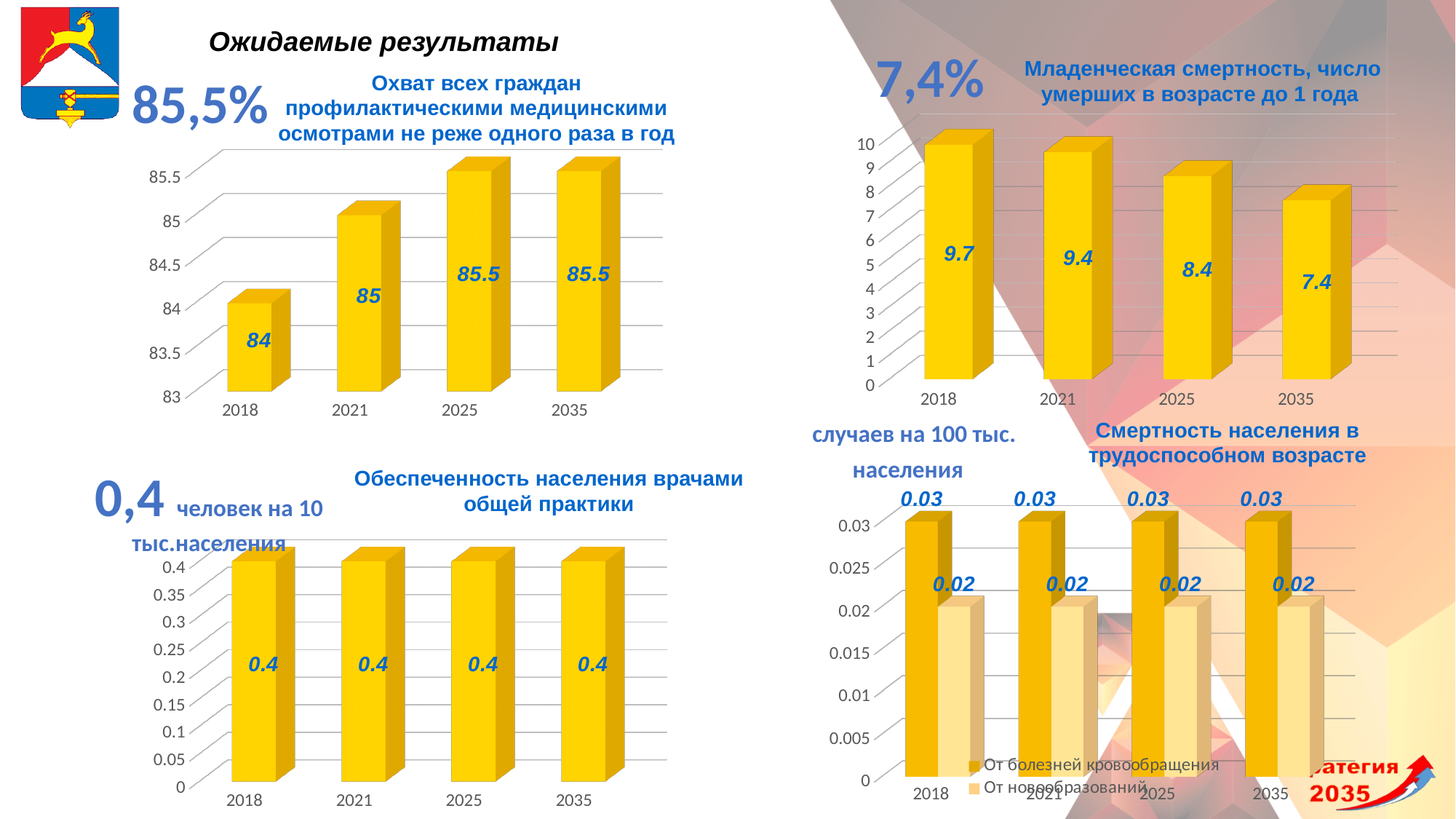
In the chart 'Младенческая смертность, число умерших в возрасте до 1 года', do the values rise or fall from 2018 to 2035? fall In the chart 'Охват всех граждан профилактическими медицинскими осмотрами не реже одного раза в год', what is the value for 2021? 85 In the chart 'Младенческая смертность, число умерших в возрасте до 1 года', what is the value for 2025? 8.4 In the chart 'Младенческая смертность, число умерших в возрасте до 1 года', which year has the lowest value? 2035 How many years are shown on the x axis of the chart 'Обеспеченность населения врачами общей практики'? 4 In the chart 'Младенческая смертность, число умерших в возрасте до 1 года', what is the difference between the 2018 and 2035 values? 2.3 In the chart 'Обеспеченность населения врачами общей практики', what is the value for 2035? 0.4 In the chart 'Смертность населения в трудоспособном возрасте', which series has the larger value in 2018: 'От болезней кровообращения' or 'От новообразований'? От болезней кровообращения In the chart 'Смертность населения в трудоспособном возрасте', what is the value for 'От новообразований' in 2025? 0.02 In the chart 'Охват всех граждан профилактическими медицинскими осмотрами не реже одного раза в год', which year has the lowest value? 2018 In the chart 'Смертность населения в трудоспособном возрасте', how many series does the legend list? 2 In the chart 'Охват всех граждан профилактическими медицинскими осмотрами не реже одного раза в год', what is the difference between the 2025 and 2018 values? 1.5